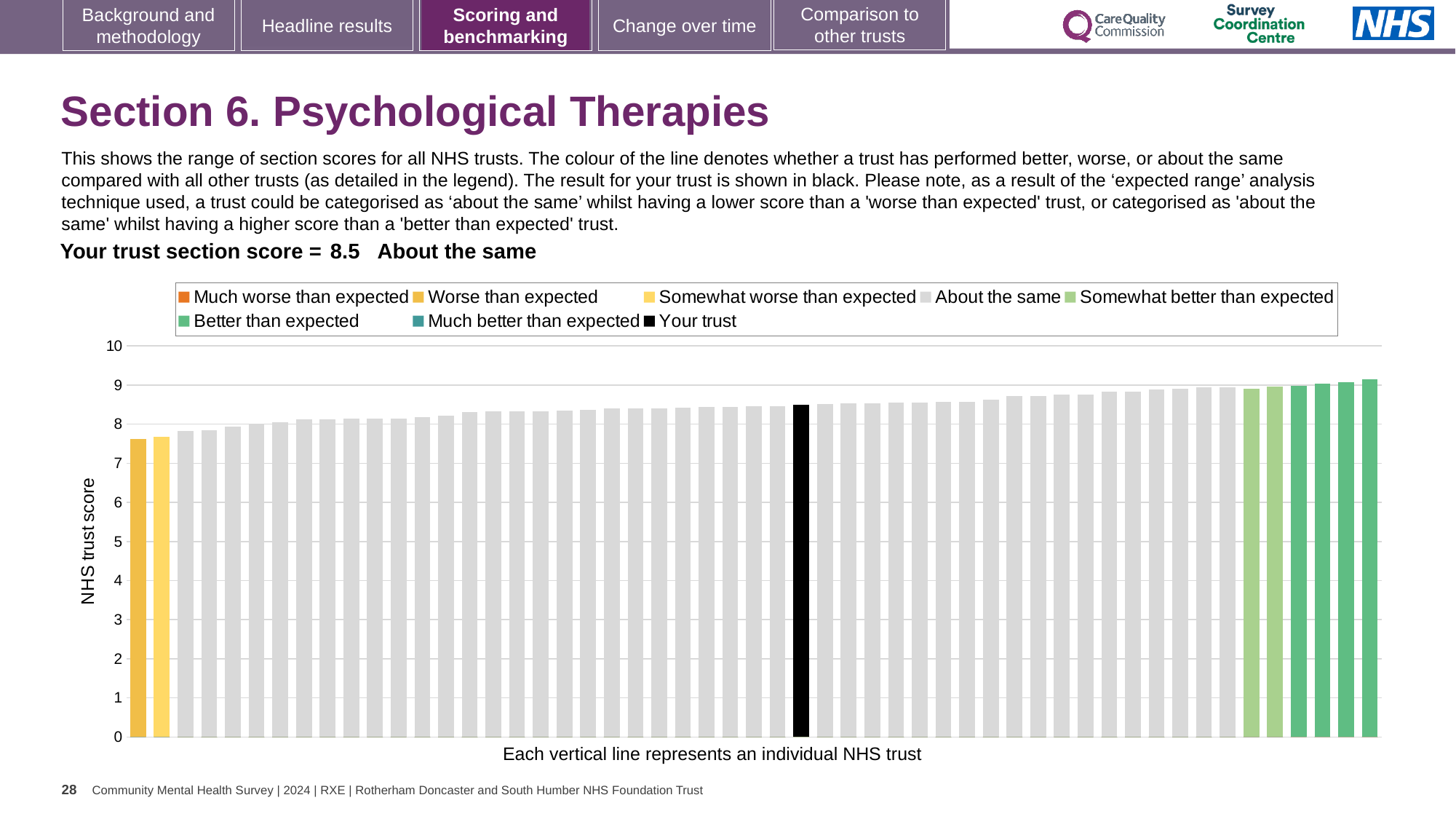
How many entries does the chart legend list? 8 Is the value for your trust (the black bar) greater or less than 8? greater How many bars are coloured as 'Better than expected' (green)? 4 What is the label on the vertical axis of the chart? NHS trust score Is the value of the rightmost (highest) bar greater or less than 8? greater Which performance category is your trust placed in for Section 6? About the same Is the value of the leftmost (lowest) bar greater or less than 8? less What kind of chart is shown on the slide? bar chart What is the section score for your trust shown on the slide? 8.5 How many bars are coloured as 'Worse than expected' (yellow)? 1 Do the bar values rise or fall from left to right along the x axis? rise What colour is used for the bar representing your trust? black